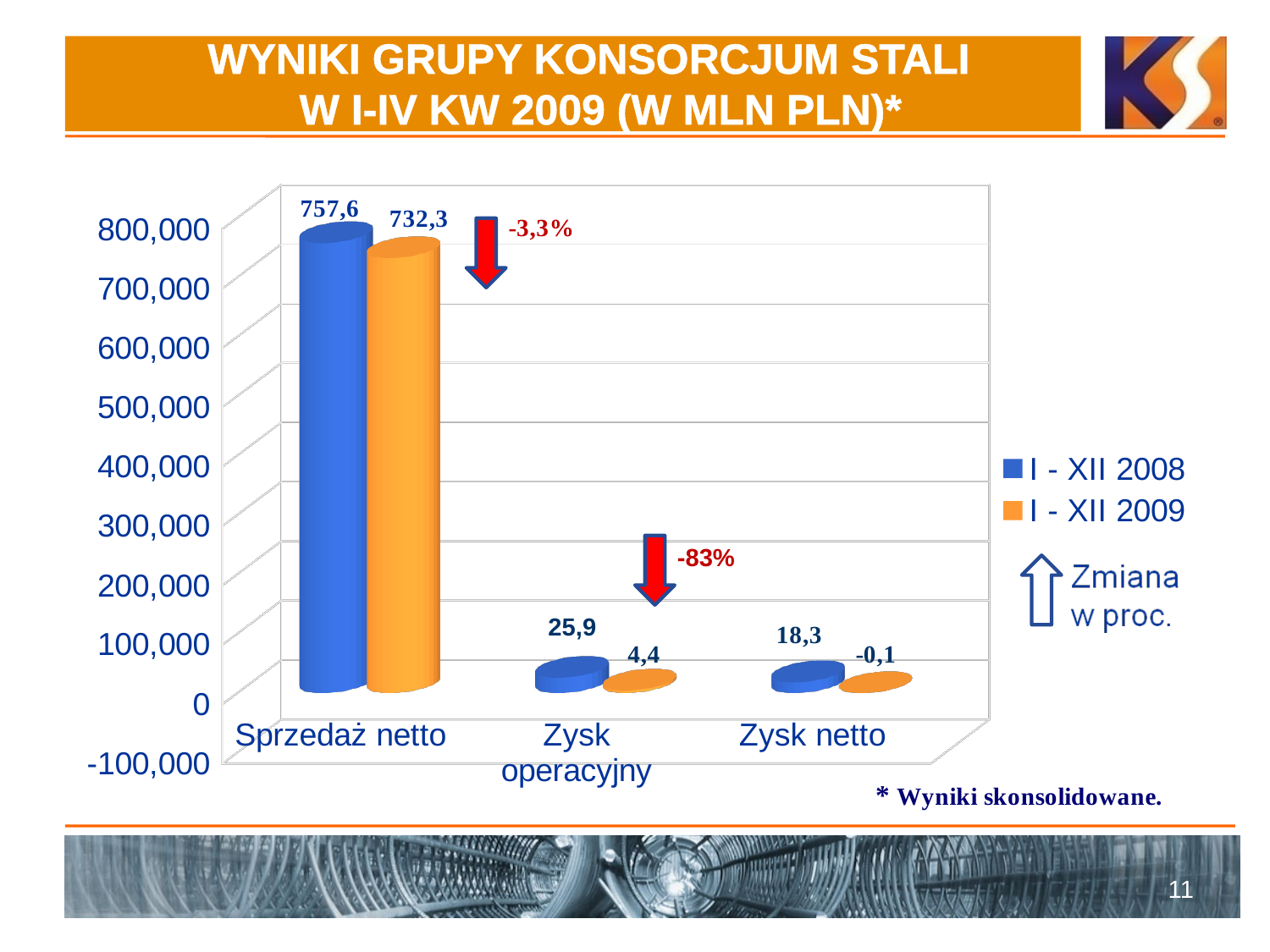
What is the value for Sprzedaż netto in the I - XII 2008 series? 757,6 What is the value for Zysk operacyjny in the I - XII 2009 series? 4,4 What is the value for Zysk netto in the I - XII 2009 series? -0,1 What percentage change is shown above the Zysk operacyjny bars? -83% What is the difference between the I - XII 2008 and I - XII 2009 values for Zysk operacyjny? 21,5 How many categories are shown on the x axis? 3 How many series does the legend list? 2 Which category has the lowest value in the I - XII 2009 series? Zysk netto What is the value for Zysk netto in the I - XII 2008 series? 18,3 Which category has the highest value in the I - XII 2008 series? Sprzedaż netto What is the value for Sprzedaż netto in the I - XII 2009 series? 732,3 Which is larger for Sprzedaż netto: the I - XII 2008 value or the I - XII 2009 value? I - XII 2008